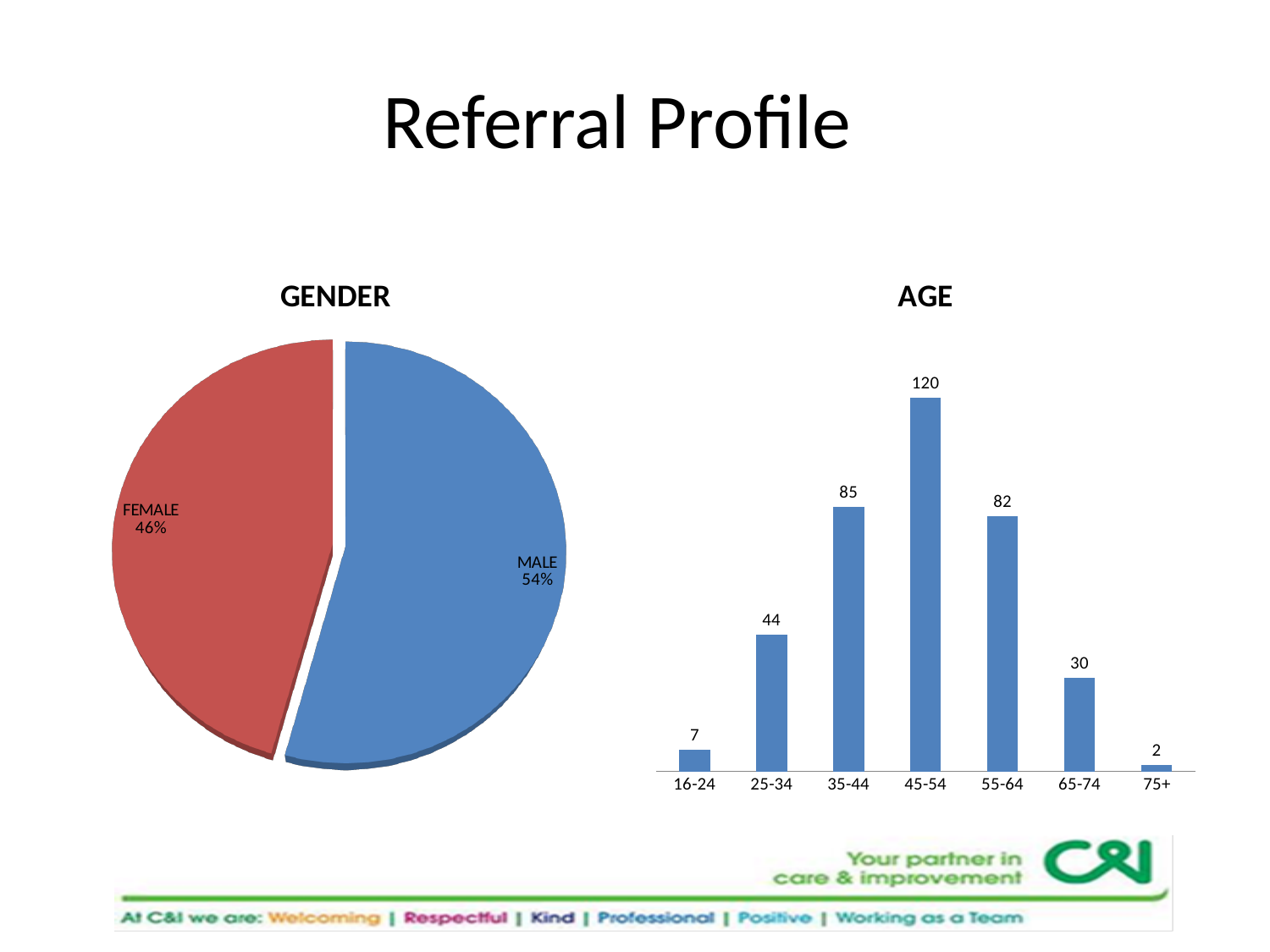
What kind of chart is the AGE chart? Bar chart In the AGE chart, which is larger, the value for 16-24 or the value for 65-74? 65-74 In the GENDER chart, what share of referrals are female? 46% In the AGE chart, which age group has the highest value? 45-54 In the AGE chart, what is the difference between the values for 35-44 and 55-64? 3 In the AGE chart, what is the value for the 45-54 age group? 120 In the AGE chart, how many age groups are shown? 7 In the GENDER chart, what share of referrals are male? 54% In the GENDER chart, which slice is larger, MALE or FEMALE? MALE In the AGE chart, what is the value for the 25-34 age group? 44 In the AGE chart, which age group has the lowest value? 75+ What kind of chart is the GENDER chart? Pie chart